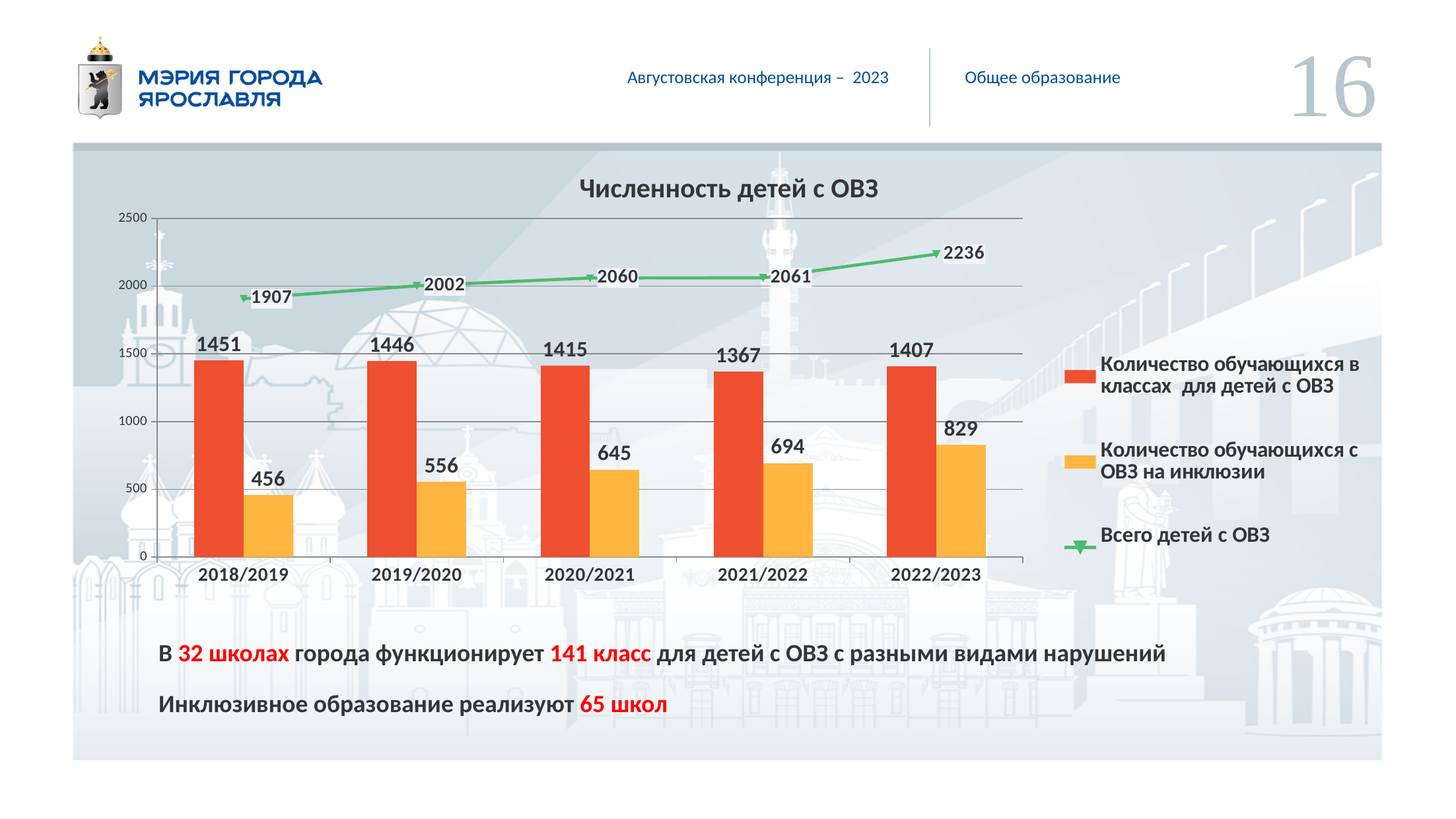
What kind of chart is used for 'Всего детей с ОВЗ'? line chart In which year is 'Количество обучающихся с ОВЗ на инклюзии' the lowest? 2018/2019 What is the value of 'Всего детей с ОВЗ' for 2020/2021? 2060 How many school years are shown on the x axis? 5 What is the title of the chart? Численность детей с ОВЗ Does 'Количество обучающихся с ОВЗ на инклюзии' rise or fall from 2018/2019 to 2022/2023? rise Which is larger: 'Количество обучающихся в классах для детей с ОВЗ' in 2019/2020 or in 2022/2023? 2019/2020 How many series does the legend list? 3 What is the value of 'Количество обучающихся в классах для детей с ОВЗ' for 2018/2019? 1451 What is the difference between 'Количество обучающихся с ОВЗ на инклюзии' in 2022/2023 and 2021/2022? 135 What is the value of 'Количество обучающихся с ОВЗ на инклюзии' for 2022/2023? 829 In which year is 'Всего детей с ОВЗ' the highest? 2022/2023